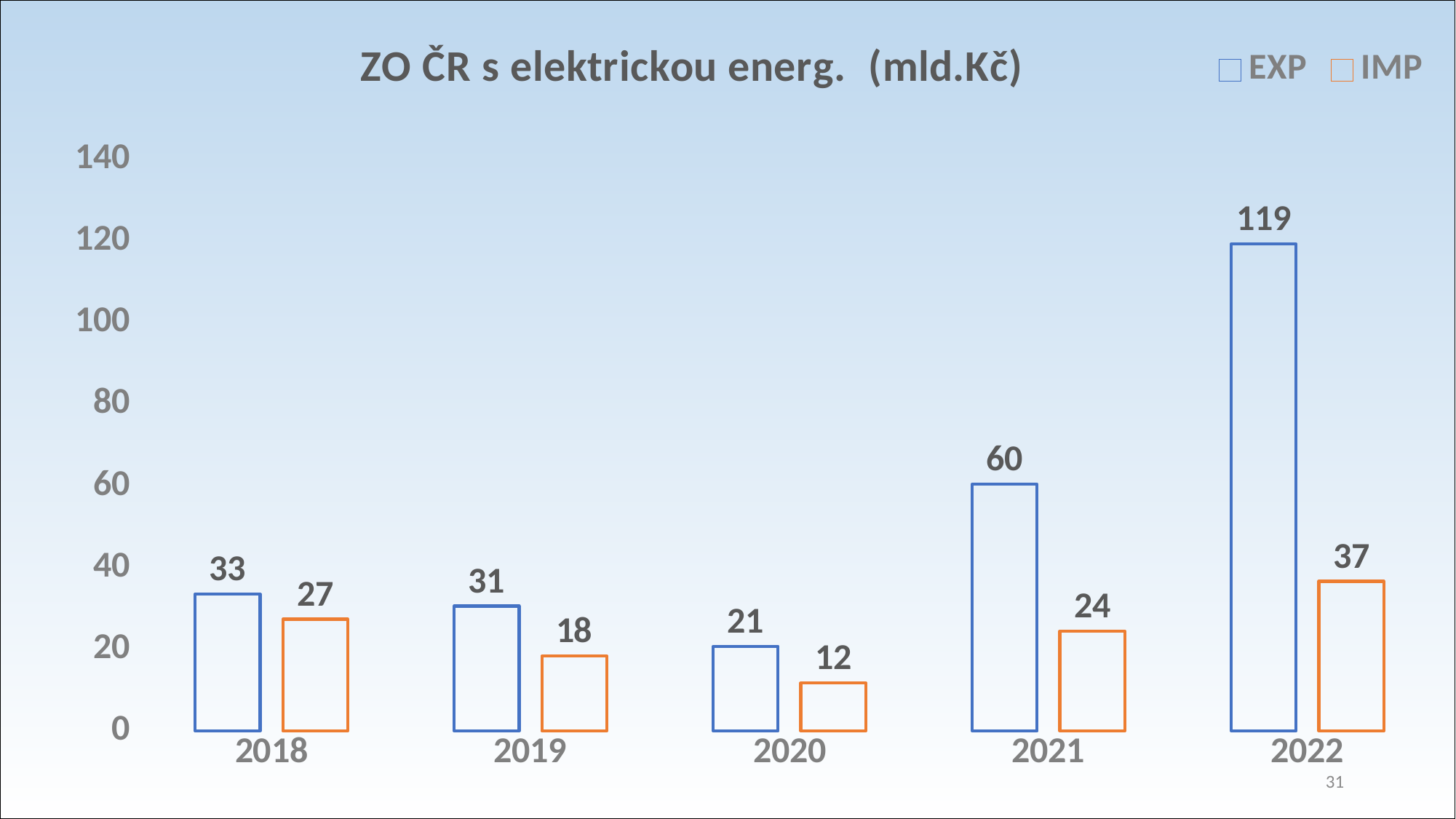
What is the EXP value for 2022? 119 What is the title of the chart? ZO ČR s elektrickou energ. (mld.Kč) How many series does the legend list? 2 Which is larger in 2018, EXP or IMP? EXP What is the difference between the EXP and IMP values in 2021? 36 Which year has the highest EXP value? 2022 What kind of chart is shown on the slide? bar chart Which year has the lowest IMP value? 2020 What is the EXP value for 2020? 21 Is the EXP value for 2022 greater or less than 100? greater What is the IMP value for 2019? 18 How many years are shown on the x axis? 5